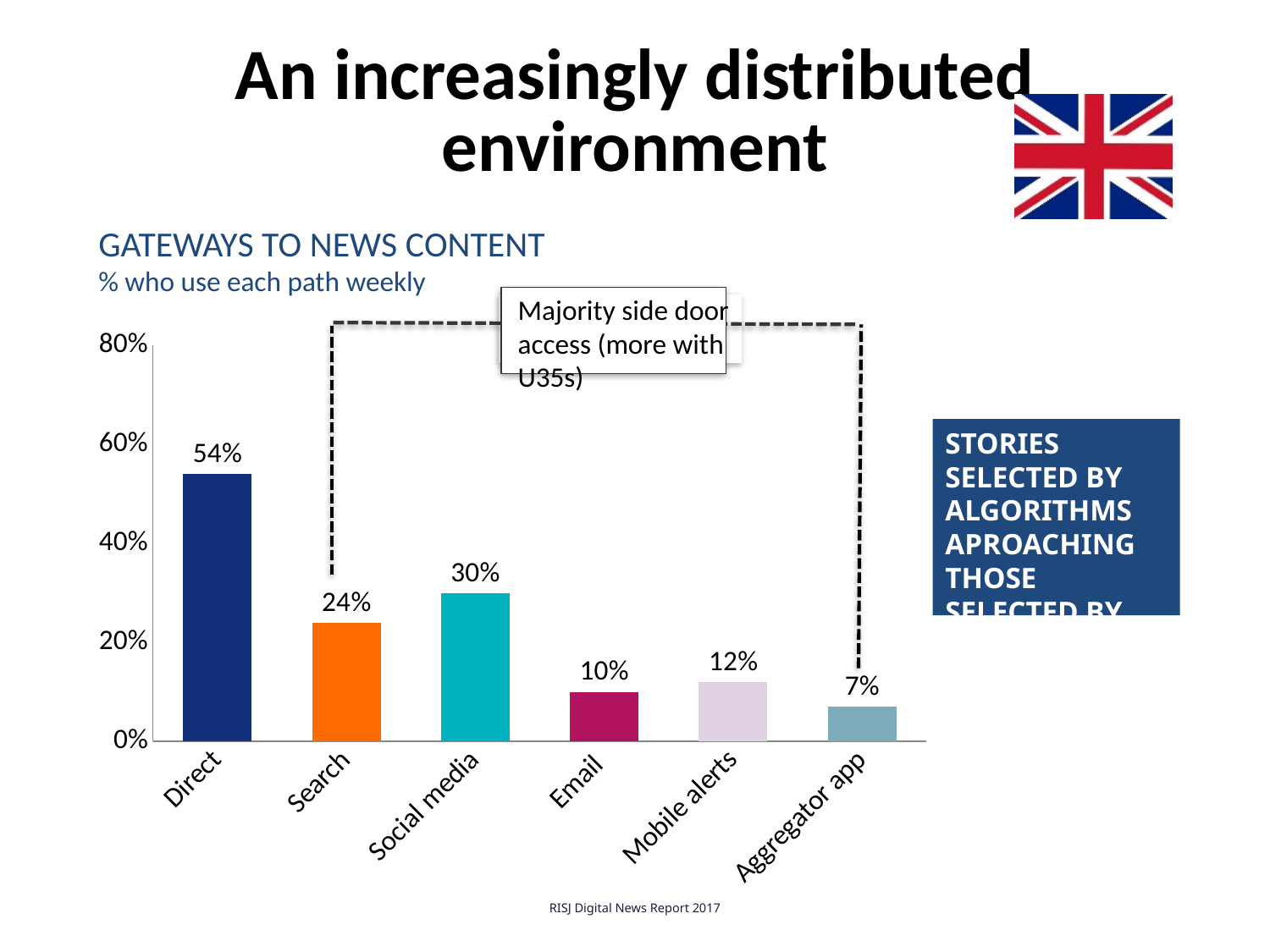
Which is larger, the value for Social media or the value for Search? Social media Which gateway has the highest weekly usage? Direct What is the value shown for Social media? 30% What percentage of people use Direct as a gateway to news content weekly? 54% What is the value shown for Aggregator app? 7% What kind of chart is shown on the slide? Bar chart What is the difference between the values for Direct and Search? 30% What is the difference between the values for Mobile alerts and Email? 2% What is the title of the chart? GATEWAYS TO NEWS CONTENT Is the value for Direct greater or less than 40%? greater Which gateway has the lowest weekly usage? Aggregator app How many gateways are shown on the chart? 6